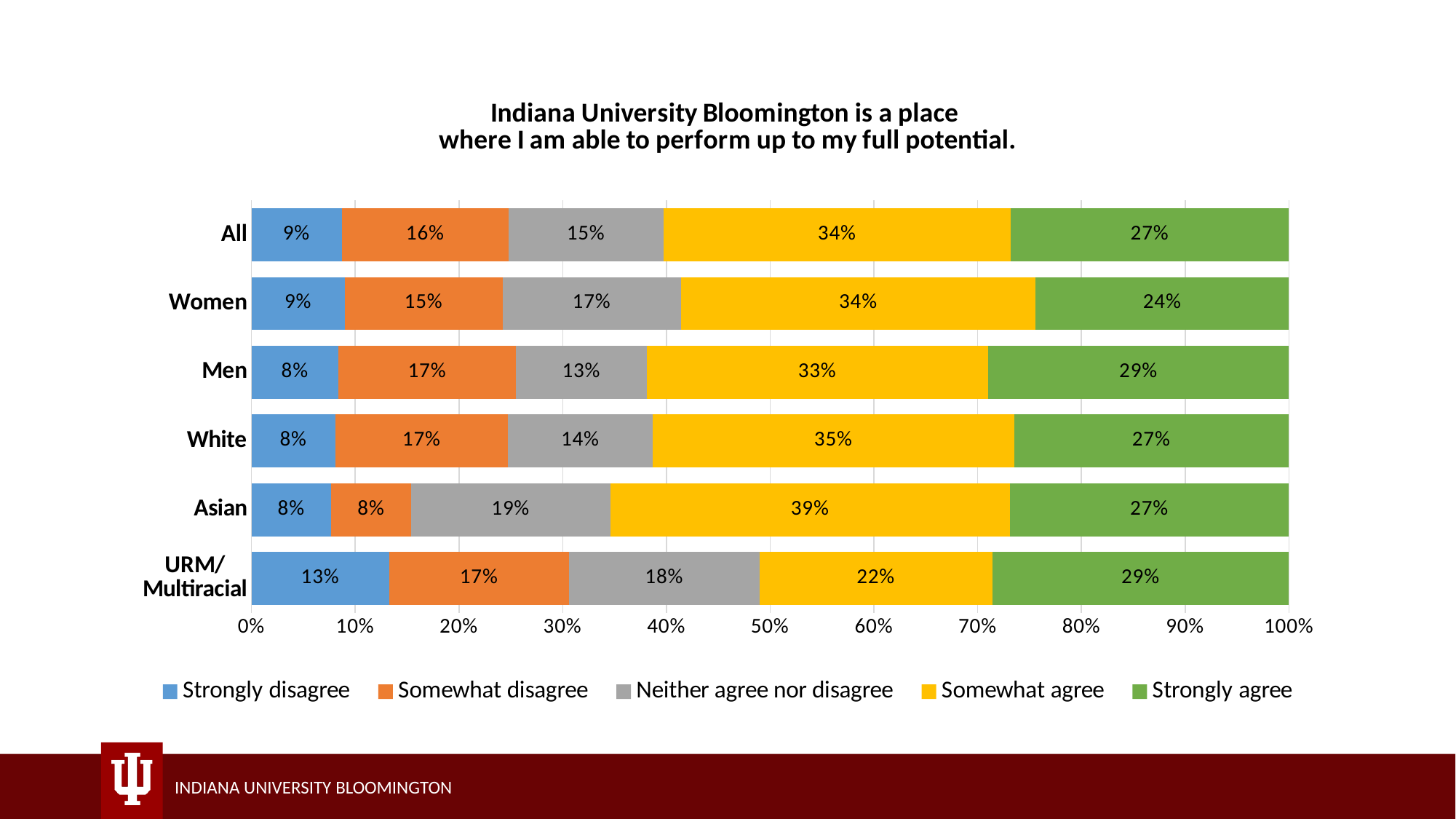
What percentage of Asian respondents selected "Somewhat agree"? 39% Which group has the lowest "Somewhat agree" percentage? URM/Multiracial Which is larger: the "Neither agree nor disagree" percentage for Asian or for Men? Asian How many groups (categories) are shown on the chart? 6 What percentage of URM/Multiracial respondents selected "Strongly disagree"? 13% What kind of chart is shown on the slide? Stacked bar chart Which group has the highest "Somewhat agree" percentage? Asian What percentage of Women selected "Strongly agree"? 24% What is the combined percentage of "Somewhat agree" and "Strongly agree" for the All group? 61% Which colour represents "Somewhat disagree" in the legend? Orange What is the difference between the "Strongly agree" percentages for Men and Women? 5% How many series does the legend list? 5